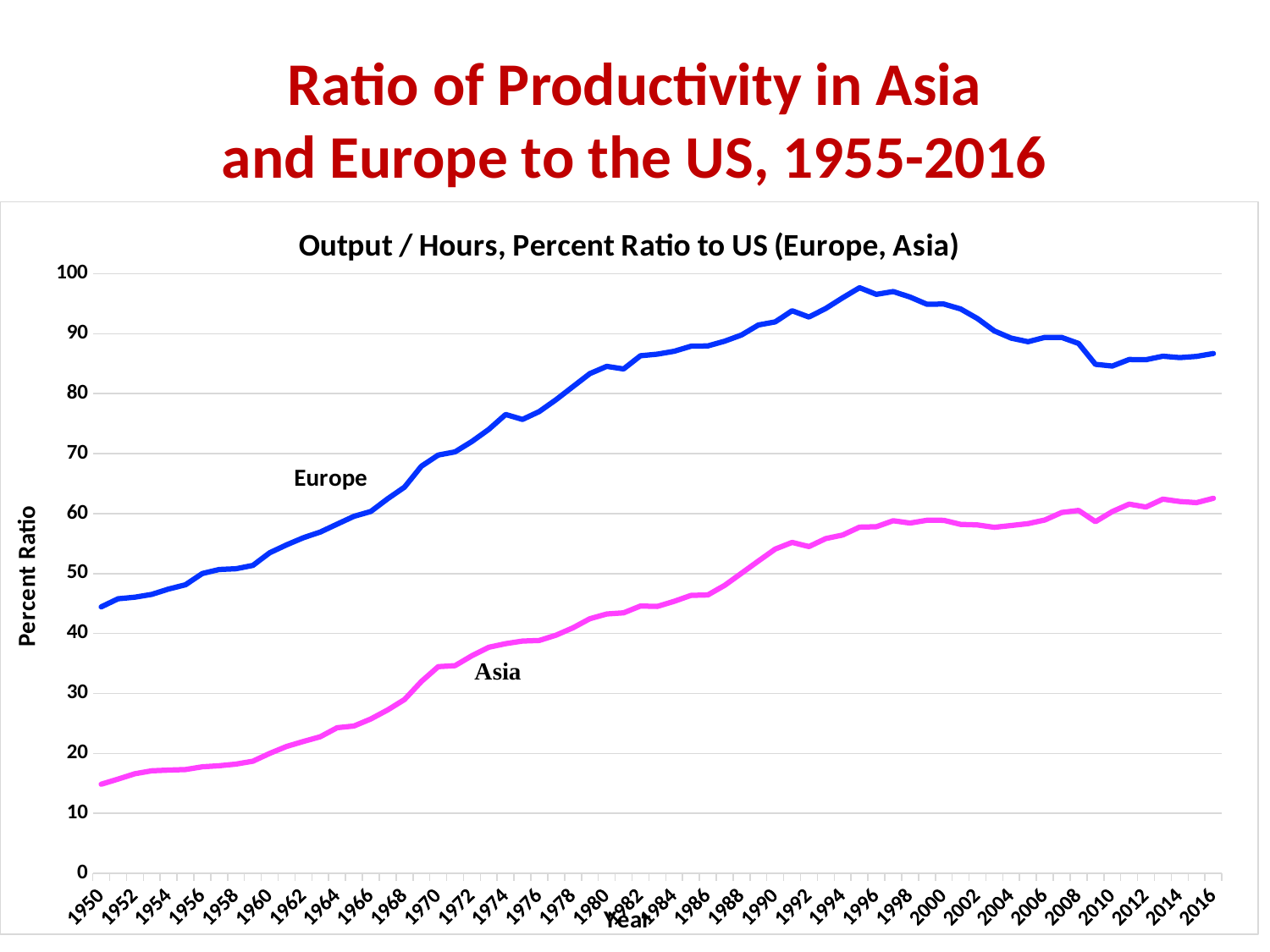
Is the value for Asia in 1990 greater or less than 50? greater Does the Asia series generally rise or fall from 1950 to 2016? rise How many series are plotted on the chart? 2 Is the value for Europe in 1950 greater or less than 40? greater Is the value for Europe in 2016 greater or less than 80? greater Does the Europe series rise or fall between 1950 and 1990? rise What is the title printed above the plot area of the chart? Output / Hours, Percent Ratio to US (Europe, Asia) What kind of chart is shown on the slide? line chart Which two series are plotted on the chart? Europe and Asia Which series has the higher value in 1990, Europe or Asia? Europe Which series has the higher value in 2016, Europe or Asia? Europe